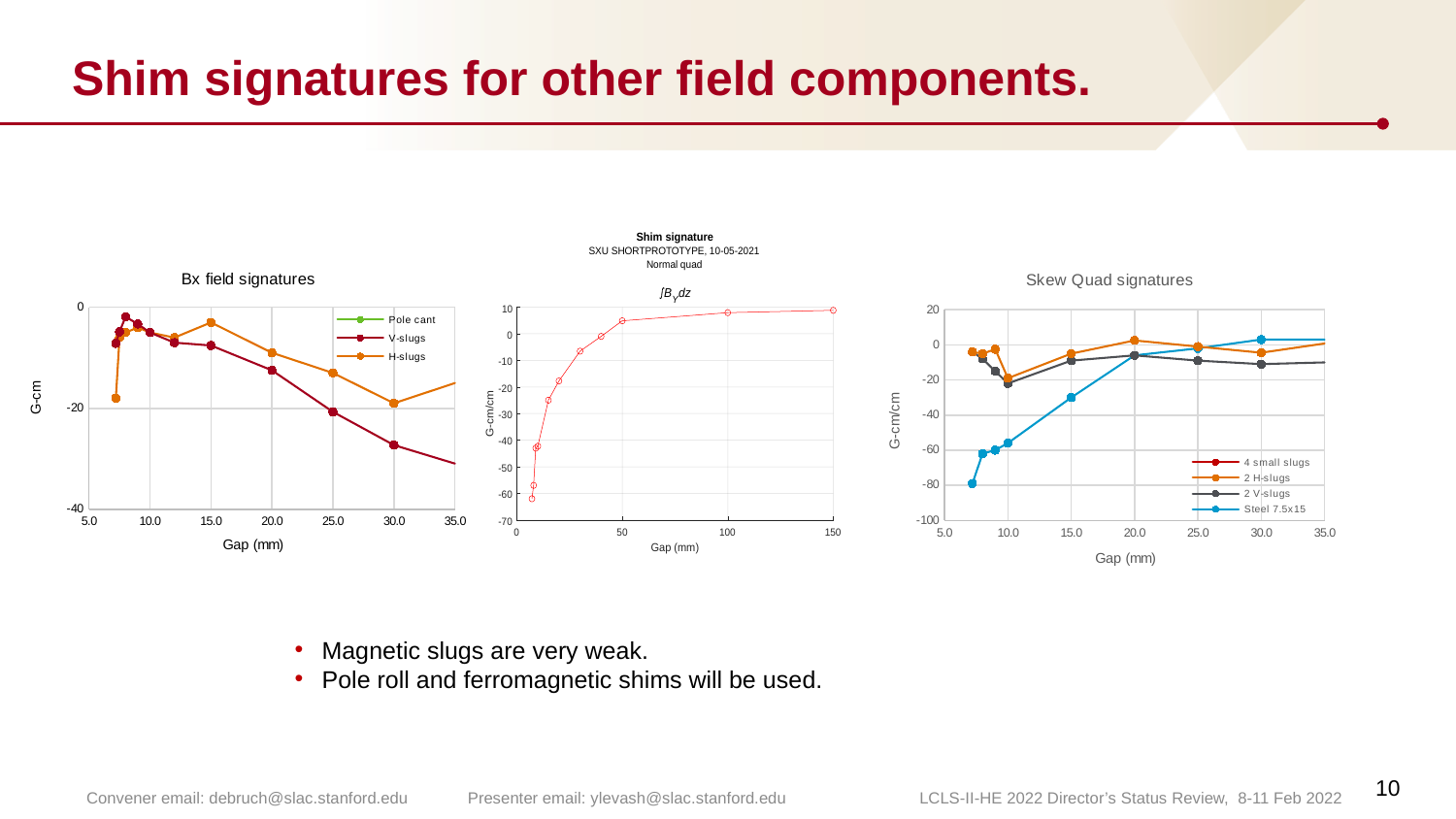
In the 'Bx field signatures' chart, how many series does the legend list? 3 In the 'Bx field signatures' chart, do the V-slugs values rise or fall as the gap increases from 10 mm to 35 mm? Fall In the 'Bx field signatures' chart, is the V-slugs value at a gap of 30.0 mm greater or less than -20? less In the 'Skew Quad signatures' chart, at a gap of 15.0 mm, which is larger: the 2 V-slugs value or the Steel 7.5x15 value? 2 V-slugs What kind of chart is the 'Bx field signatures' chart? Line chart In the 'Bx field signatures' chart, what are the legend entries? Pole cant, V-slugs, H-slugs In the 'Skew Quad signatures' chart, which series has the lowest value at the smallest gap? Steel 7.5x15 In the middle 'Shim signature' chart, do the values rise or fall as the gap increases? Rise In the 'Skew Quad signatures' chart, how many series does the legend list? 4 In the middle 'Shim signature' chart, what is the y-axis label? G-cm/cm In the middle 'Shim signature' chart, is the value at a gap of 150 mm greater or less than 0? greater In the 'Bx field signatures' chart, is the H-slugs value at a gap of 15.0 mm greater or less than -10? greater